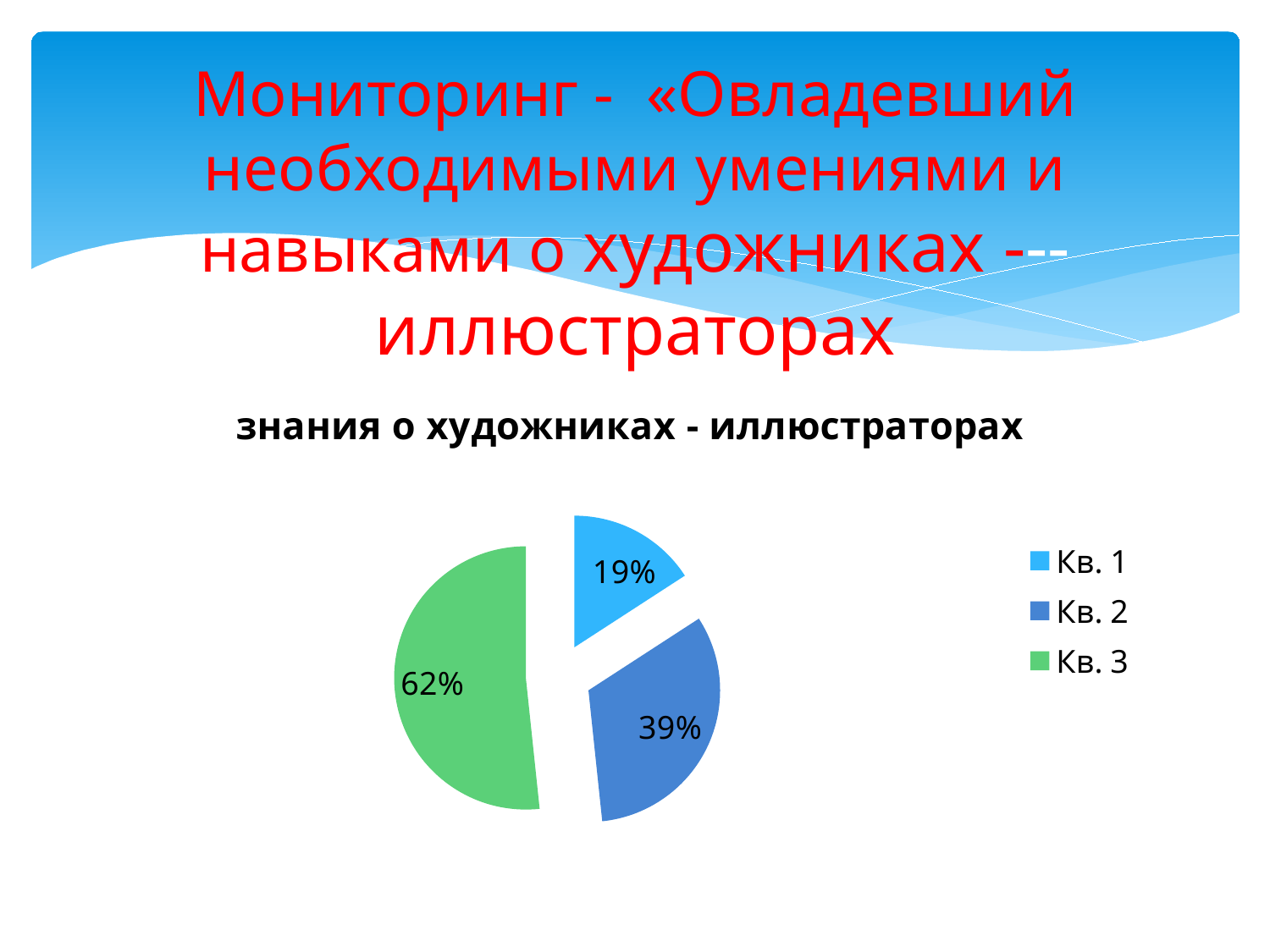
How many slices does the pie chart have? 3 What kind of chart is shown on the slide? pie chart What share of the pie does Кв. 1 have? 19% What share of the pie does Кв. 2 have? 39% What share of the pie does Кв. 3 have? 62% Which category has the smallest slice of the pie? Кв. 1 What is the difference in percentage points between the Кв. 2 slice and the Кв. 1 slice? 20 Which is larger, the slice for Кв. 2 or the slice for Кв. 1? Кв. 2 Which category has the largest slice of the pie? Кв. 3 What is the chart's title? знания о художниках - иллюстраторах What colour is the slice for Кв. 3? green What is the difference in percentage points between the Кв. 3 slice and the Кв. 1 slice? 43